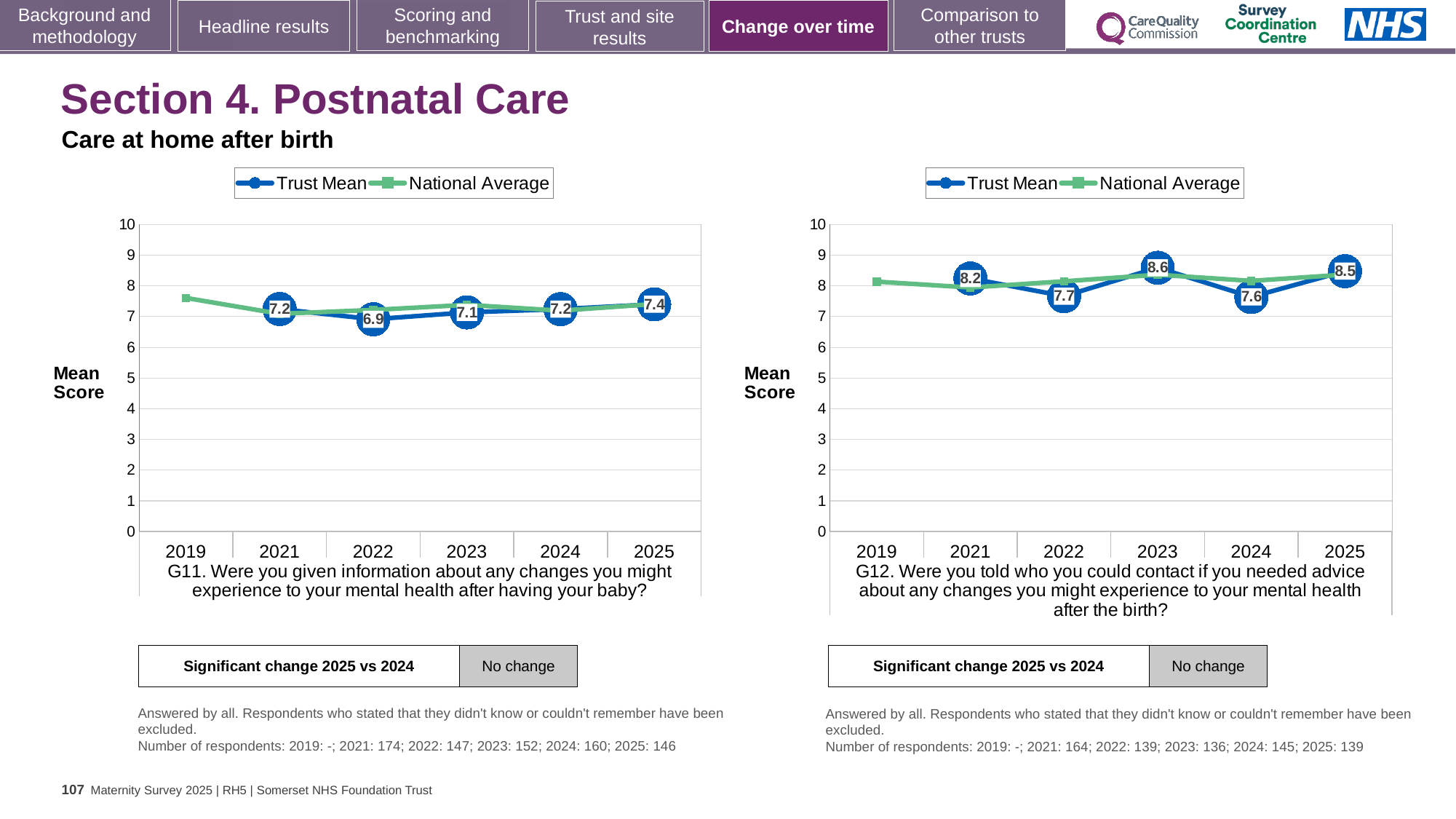
In the G11 chart on the left, what is the Trust Mean score for 2025? 7.4 What kind of chart is the G11 chart on the left? Line chart How many series does the legend of the G12 chart on the right list? 2 In the G12 chart on the right, what is the difference between the Trust Mean scores for 2023 and 2024? 1.0 In the G12 chart on the right, what is the Trust Mean score for 2023? 8.6 In the G11 chart on the left, which year has the lowest Trust Mean score? 2022 In the G12 chart on the right, what is the Trust Mean score for 2024? 7.6 In the G11 chart on the left, what is the Trust Mean score for 2022? 6.9 In the G11 chart on the left, is the National Average for 2019 greater or less than 7? greater In the G11 chart on the left, what is the difference between the Trust Mean scores for 2025 and 2022? 0.5 In the G12 chart on the right, is the Trust Mean score for 2021 or 2022 larger? 2021 In the G12 chart on the right, which year has the highest Trust Mean score? 2023